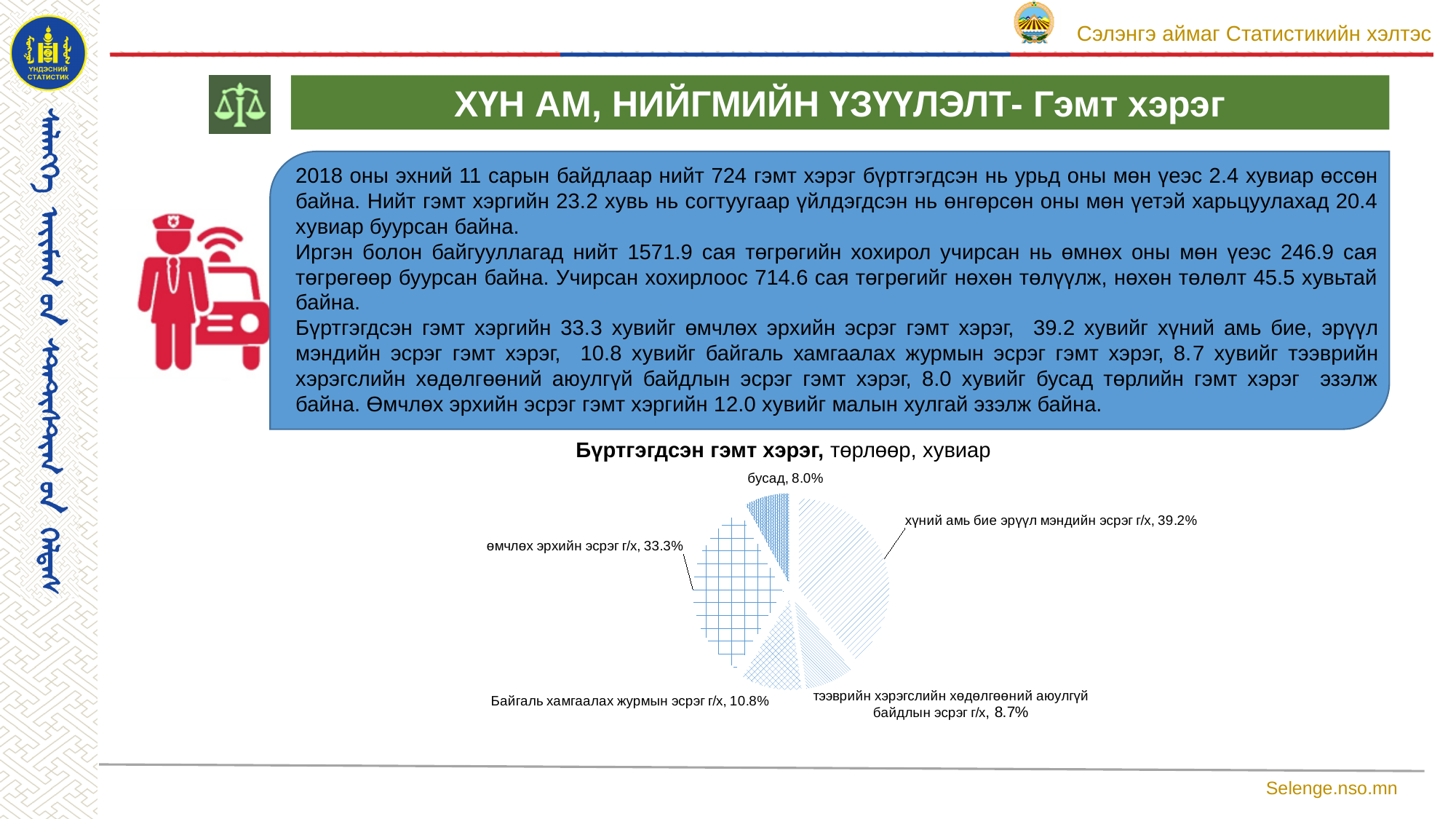
What share of the pie is labelled 'өмчлөх эрхийн эсрэг г/х'? 33.3% How many slices does the pie chart have? 5 What share of the pie is labelled 'хүний амь бие эрүүл мэндийн эсрэг г/х'? 39.2% What share of the pie is labelled 'тээврийн хэрэгслийн хөдөлгөөний аюулгүй байдлын эсрэг г/х'? 8.7% What kind of chart is shown on the slide? pie chart What share of the pie is labelled 'Байгаль хамгаалах журмын эсрэг г/х'? 10.8% Which category has the largest share of the pie? хүний амь бие эрүүл мэндийн эсрэг г/х Which category has the smallest share of the pie? бусад What is the difference in percentage points between 'хүний амь бие эрүүл мэндийн эсрэг г/х' and 'өмчлөх эрхийн эсрэг г/х'? 5.9 What share of the pie is labelled 'бусад'? 8.0% Which is larger: the share for 'Байгаль хамгаалах журмын эсрэг г/х' or the share for 'тээврийн хэрэгслийн хөдөлгөөний аюулгүй байдлын эсрэг г/х'? Байгаль хамгаалах журмын эсрэг г/х What is the title of the chart? Бүртгэгдсэн гэмт хэрэг, төрлөөр, хувиар